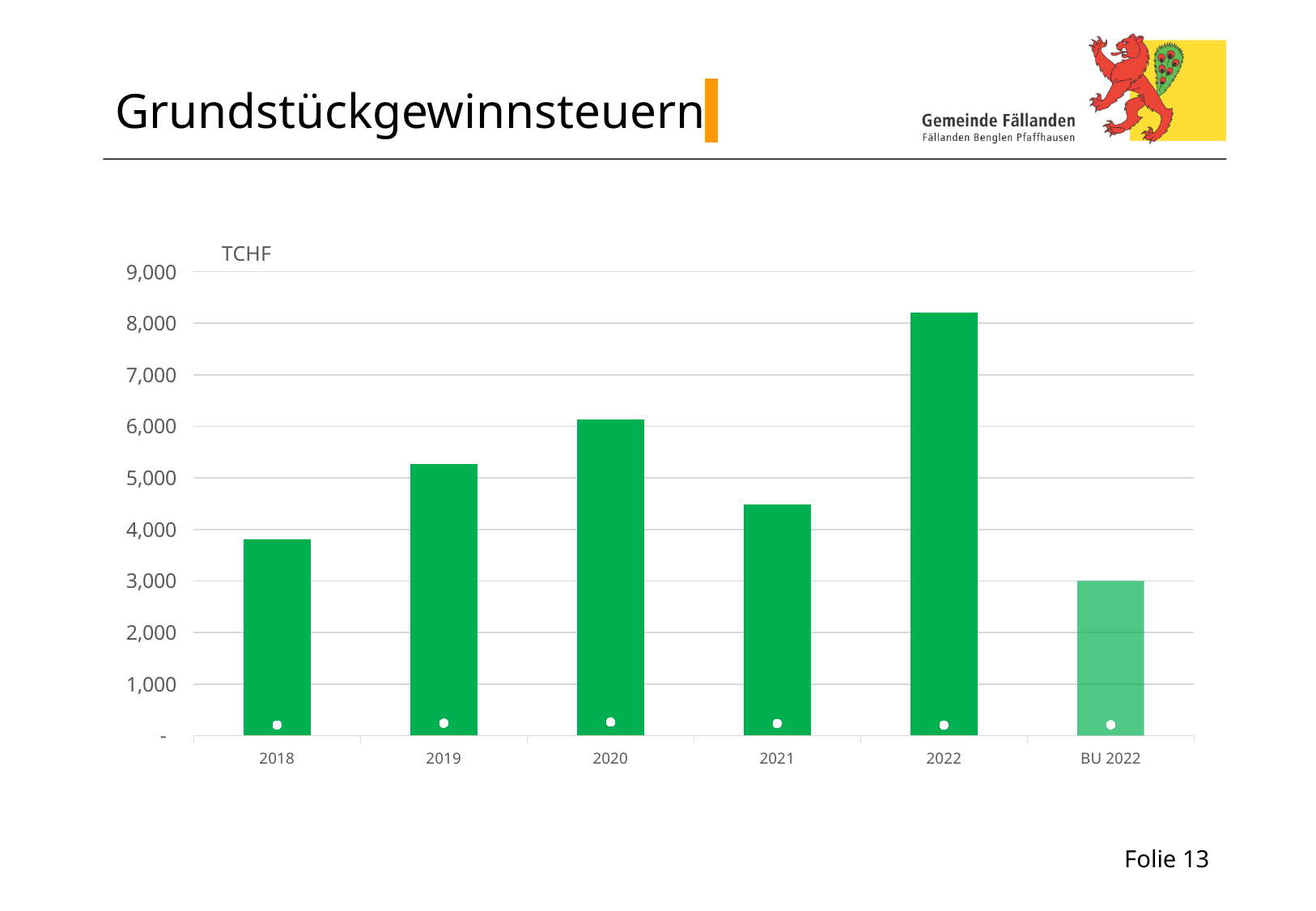
Which category has the lowest value in the chart? BU 2022 Is the value for 2018 greater or less than 4,000? less Is the value for 2020 greater or less than 6,000? greater Which is larger, the value for 2020 or the value for 2022? 2022 Which category has the highest value in the chart? 2022 Is the value for 2022 greater or less than 8,000? greater How many bars are plotted in the chart? 6 Which is larger, the value for 2019 or the value for 2021? 2019 What kind of chart is shown on the slide? bar chart What is the title of the slide containing the chart? Grundstückgewinnsteuern What unit label is shown above the vertical axis of the chart? TCHF